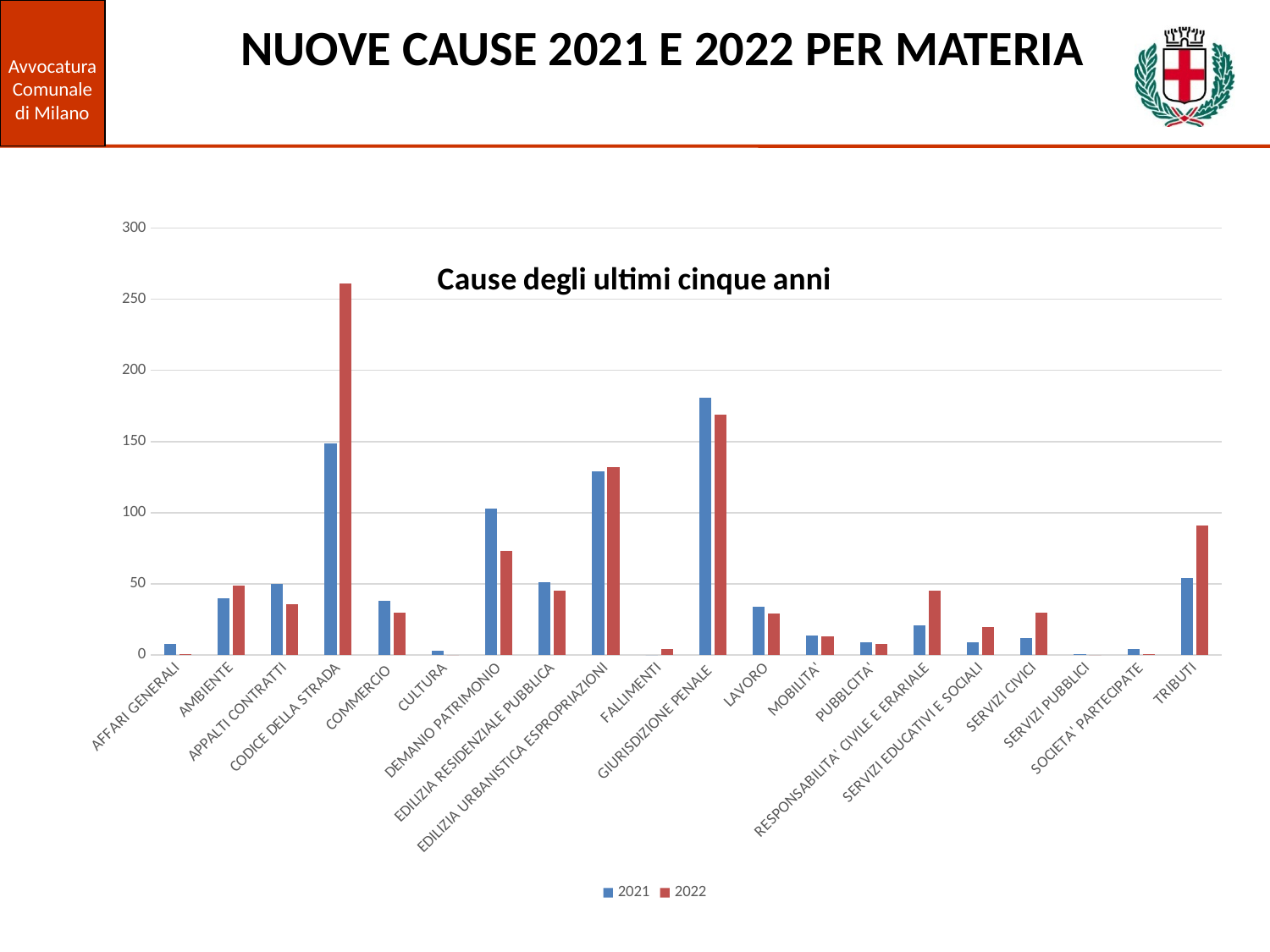
Is the 2022 value for TRIBUTI greater or less than 50? greater Is the 2022 value for CODICE DELLA STRADA greater or less than 250? greater Which category has the highest value for the 2021 series? GIURISDIZIONE PENALE How many series does the chart legend list? 2 Which colour represents the 2022 series in the chart? red For DEMANIO PATRIMONIO, which series is larger, 2021 or 2022? 2021 Which category has the highest value for the 2022 series? CODICE DELLA STRADA For CODICE DELLA STRADA, which series is larger, 2021 or 2022? 2022 How many categories are shown on the x axis of the chart? 20 Is the 2021 value for GIURISDIZIONE PENALE greater or less than 150? greater What is the title shown inside the chart area? Cause degli ultimi cinque anni What kind of chart is shown on the slide? bar chart